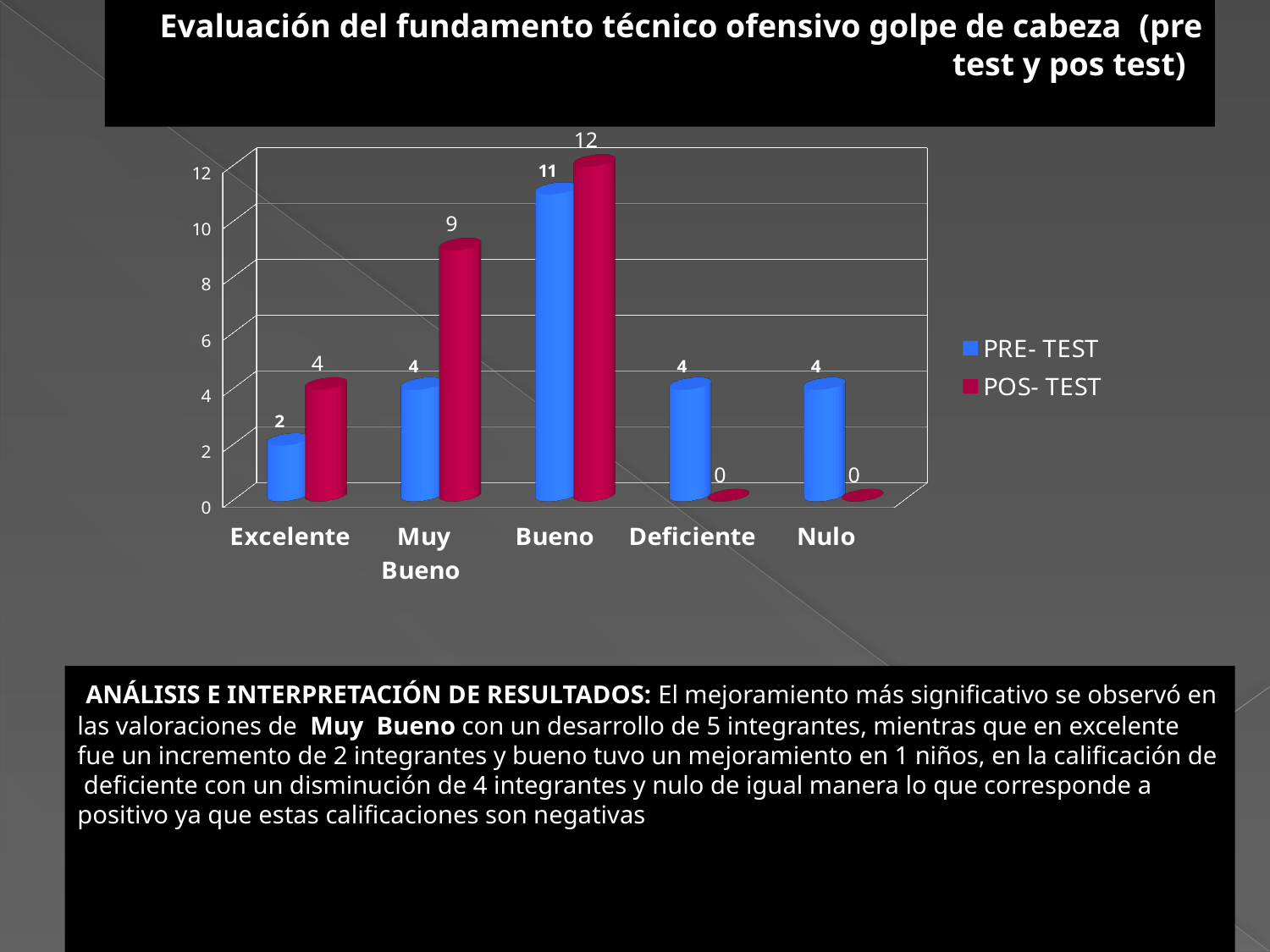
What kind of chart is shown on the slide? Bar chart What is the POS- TEST value for Muy Bueno? 9 Which category has the lowest PRE- TEST value? Excelente What is the PRE- TEST value for Bueno? 11 What is the difference between the POS- TEST and PRE- TEST values for Muy Bueno? 5 How many categories are shown on the x axis? 5 What is the PRE- TEST value for Excelente? 2 What colour are the POS- TEST bars? Red Which is larger for Nulo, the PRE- TEST value or the POS- TEST value? PRE- TEST Which category has the highest POS- TEST value? Bueno How many series does the legend list? 2 What is the POS- TEST value for Deficiente? 0